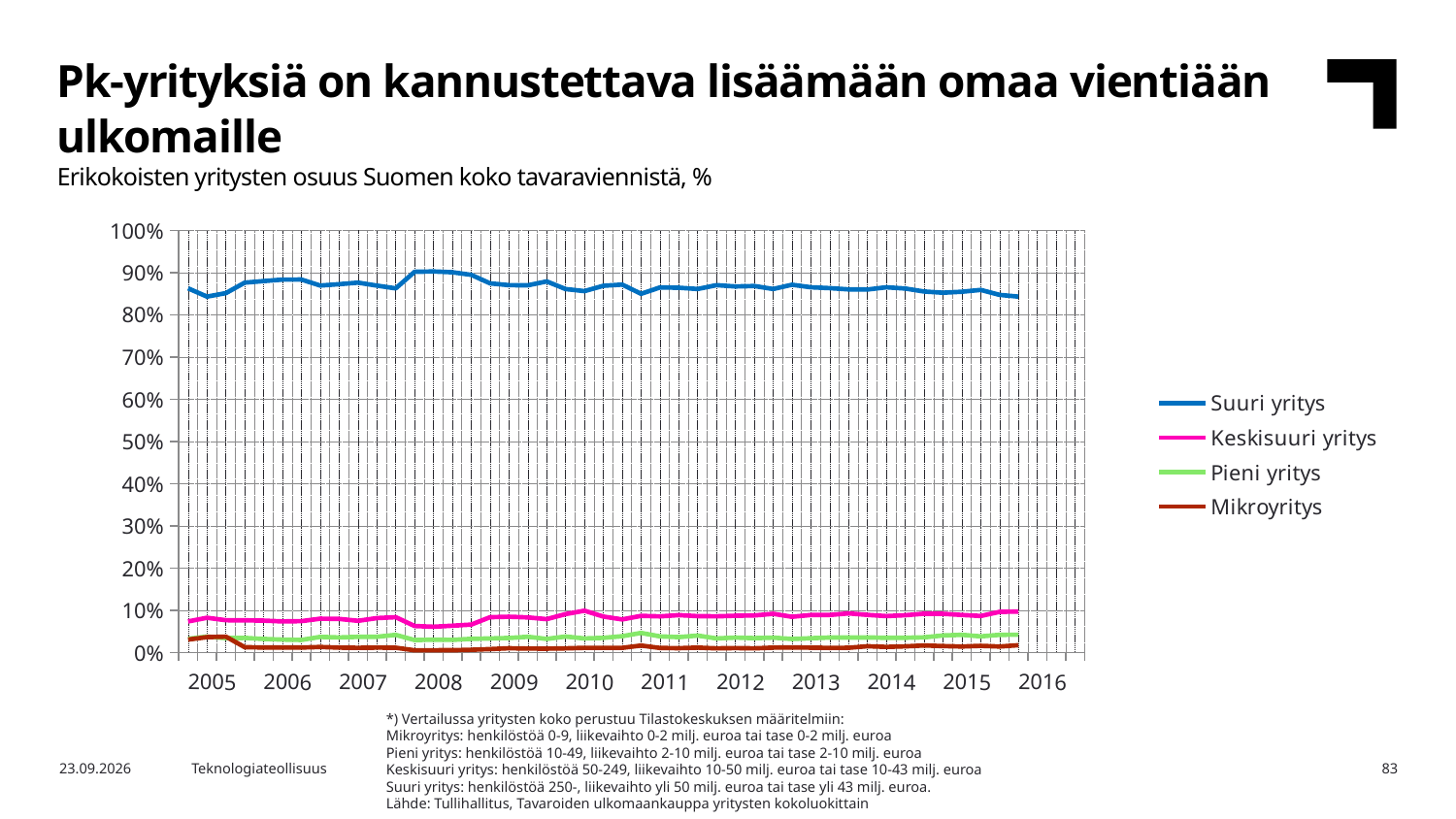
Which series has the lowest values throughout the chart? Mikroyritys How many years are labelled on the x axis? 12 What colour is the line for Suuri yritys? Blue Is the value for Suuri yritys in 2008 greater or less than 80%? greater How many series does the legend list? 4 What kind of chart is shown on the slide? Line chart Which series has the highest values throughout the chart? Suuri yritys Which is larger in 2010, the value for Keskisuuri yritys or the value for Pieni yritys? Keskisuuri yritys Is the value for Mikroyritys in 2015 greater or less than 10%? less Does the value for Suuri yritys rise or fall from 2008 to 2016? fall Is the value for Keskisuuri yritys in 2010 greater or less than 20%? less Which is larger in 2012, the value for Suuri yritys or the value for Keskisuuri yritys? Suuri yritys